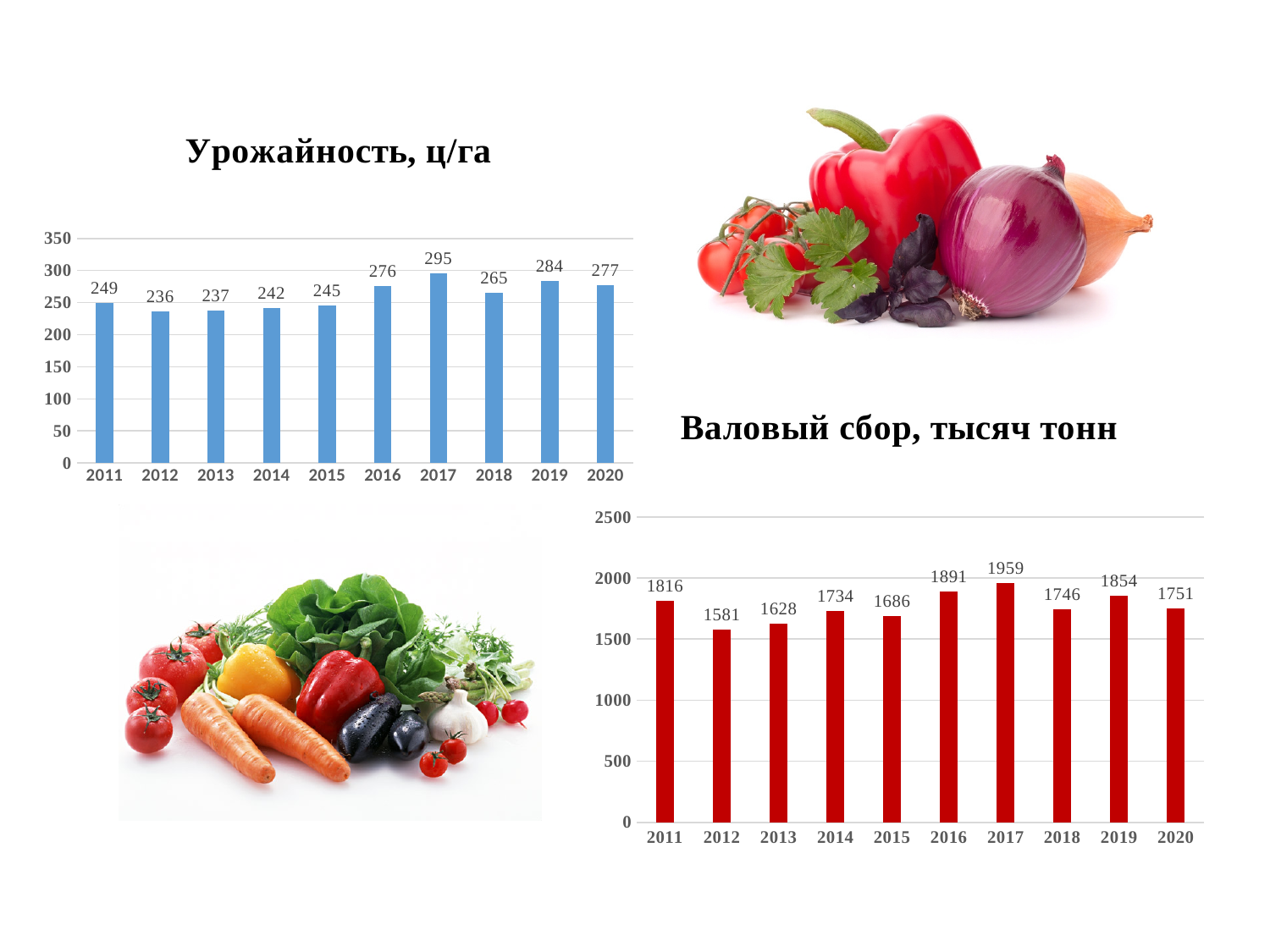
In the 'Урожайность, ц/га' chart, which year has the lowest value? 2012 What kind of chart is the 'Валовый сбор, тысяч тонн' chart? Bar chart What colour are the bars in the 'Урожайность, ц/га' chart? Blue In the 'Валовый сбор, тысяч тонн' chart, what is the value for 2019? 1854 In the 'Валовый сбор, тысяч тонн' chart, what is the difference between the values for 2017 and 2012? 378 In the 'Валовый сбор, тысяч тонн' chart, which year has the highest value? 2017 In the 'Урожайность, ц/га' chart, what is the value for 2017? 295 In the 'Валовый сбор, тысяч тонн' chart, which is larger, the value for 2014 or the value for 2015? 2014 In the 'Урожайность, ц/га' chart, is the value for 2016 greater or less than 250? greater In the 'Урожайность, ц/га' chart, what is the difference between the values for 2017 and 2011? 46 In the 'Валовый сбор, тысяч тонн' chart, which year has the lowest value? 2012 In the 'Урожайность, ц/га' chart, how many years are shown on the x axis? 10